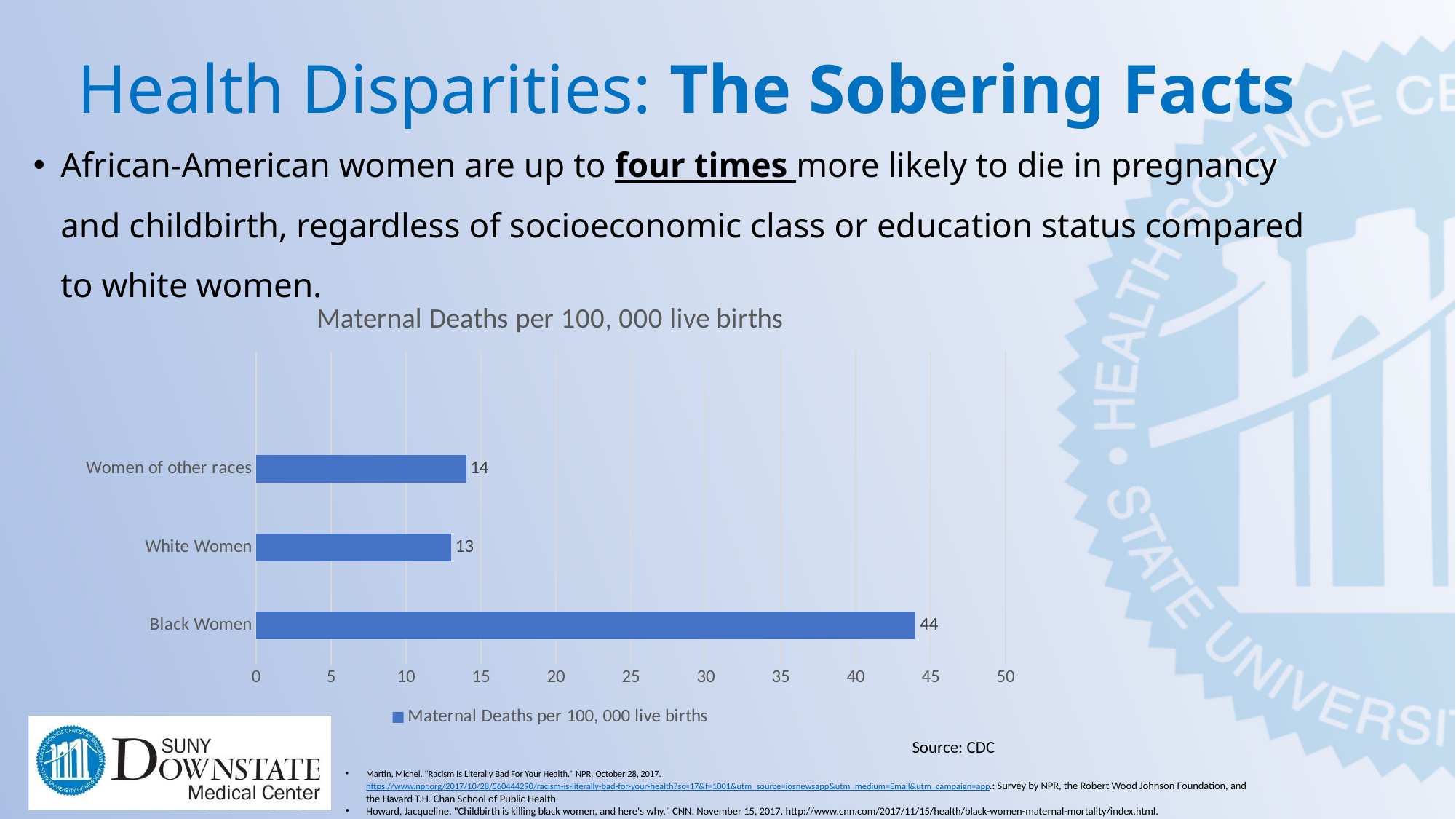
Is the value for Black Women greater or less than 40? greater What is the value for White Women in the chart? 13 What is the difference between the values for Women of other races and White Women? 1 What is the title of the chart? Maternal Deaths per 100, 000 live births What kind of chart is shown on the slide? bar chart Which category has the highest maternal deaths per 100,000 live births? Black Women Which category has the lowest maternal deaths per 100,000 live births? White Women How many categories are shown in the chart? 3 Which is larger, the value for Black Women or the value for Women of other races? Black Women What is the value for Black Women in the chart? 44 What is the value for Women of other races in the chart? 14 What is the difference between the values for Black Women and White Women? 31